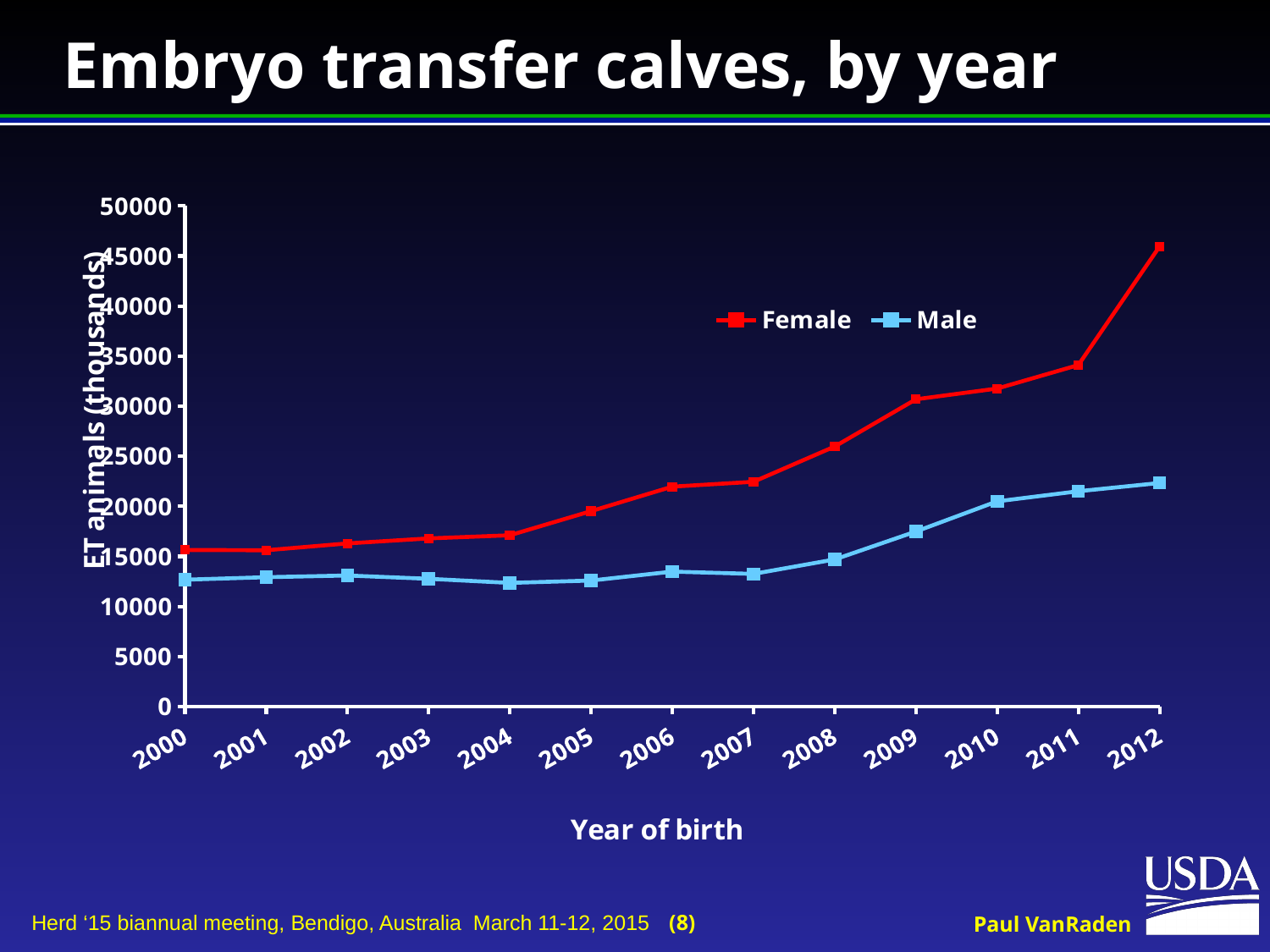
Is the Male value for 2012 greater or less than 20000? greater Which series reaches the highest value on the chart? Female In 2012, which series has the larger value, Female or Male? Female How many years are plotted along the x axis? 13 What is the title of the x axis? Year of birth Is the Male value for 2004 greater or less than 15000? less How many series does the legend list? 2 What kind of chart is shown on the slide? line chart In which year does the Female series reach its highest value? 2012 Is the Female value for 2012 greater or less than 45000? greater Does the Female series generally rise or fall from 2000 to 2012? rise